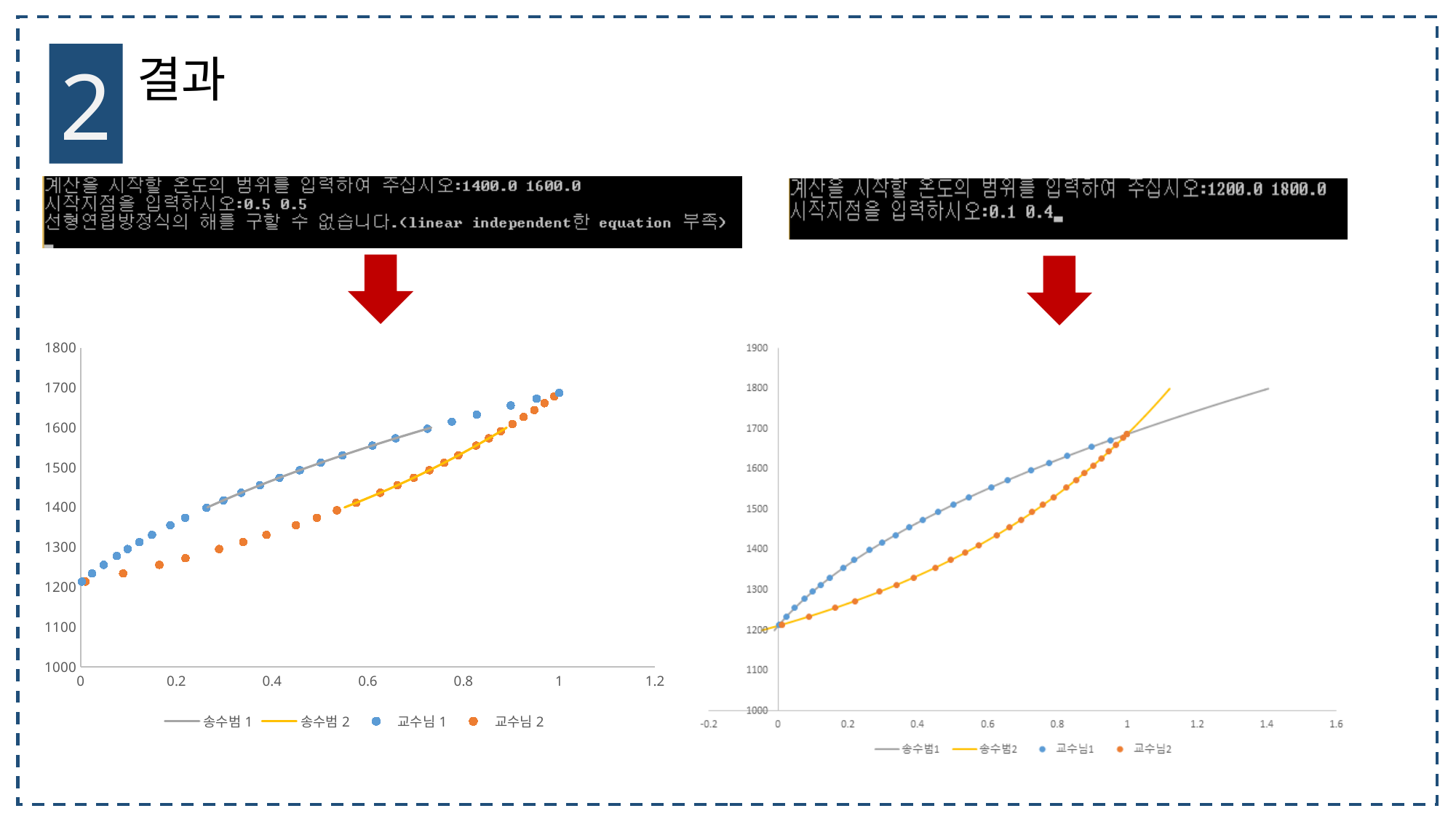
In the right chart, do the values of 교수님2 rise or fall as x increases? rise In the right chart, at x = 0.6, which series has the larger value, 교수님1 or 교수님2? 교수님1 How many series does the legend of the left chart list? 4 How many series does the legend of the right chart list? 4 In the right chart, is the value of 교수님2 at x = 0.4 greater or less than 1400? less In the left chart, is the value of 교수님 1 at x = 1 greater or less than 1600? greater In the right chart, is the value of 교수님1 at x = 0.4 greater or less than 1400? greater What is the highest tick value shown on the y axis of the right chart? 1900 What kind of chart is the left chart? scatter chart with lines In the left chart, at x = 0.6, which series has the larger value, 교수님 1 or 교수님 2? 교수님 1 In the left chart, do the values of 교수님 1 rise or fall as x increases? rise